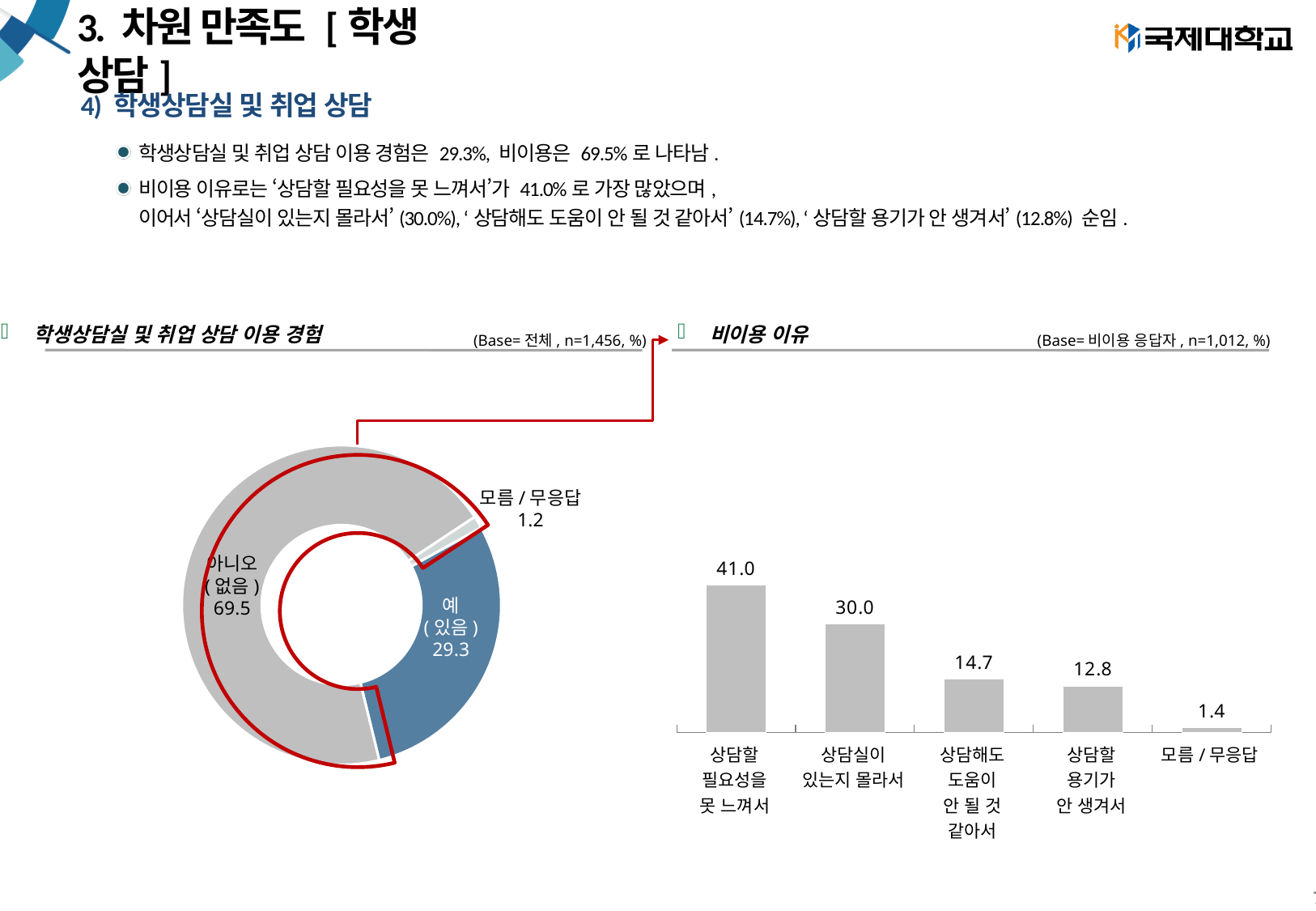
In the '비이용 이유' chart, what is the value for '상담할 용기가 안 생겨서'? 12.8 What kind of chart is the '비이용 이유' chart? Bar chart How many categories are shown in the '비이용 이유' chart? 5 What kind of chart is the '학생상담실 및 취업 상담 이용 경험' chart? Donut (pie) chart In the '비이용 이유' chart, what is the value for '상담할 필요성을 못 느껴서'? 41.0 In the '학생상담실 및 취업 상담 이용 경험' chart, which category has the largest share? 아니오 (없음) In the '비이용 이유' chart, which category has the lowest value? 모름 / 무응답 In the '학생상담실 및 취업 상담 이용 경험' chart, what is the value for '아니오 (없음)'? 69.5 In the '학생상담실 및 취업 상담 이용 경험' chart, what is the difference between '아니오 (없음)' and '예 (있음)'? 40.2 In the '학생상담실 및 취업 상담 이용 경험' chart, what is the value for '모름 / 무응답'? 1.2 In the '비이용 이유' chart, what is the difference between '상담실이 있는지 몰라서' and '상담해도 도움이 안 될 것 같아서'? 15.3 In the '학생상담실 및 취업 상담 이용 경험' chart, what is the value for '예 (있음)'? 29.3